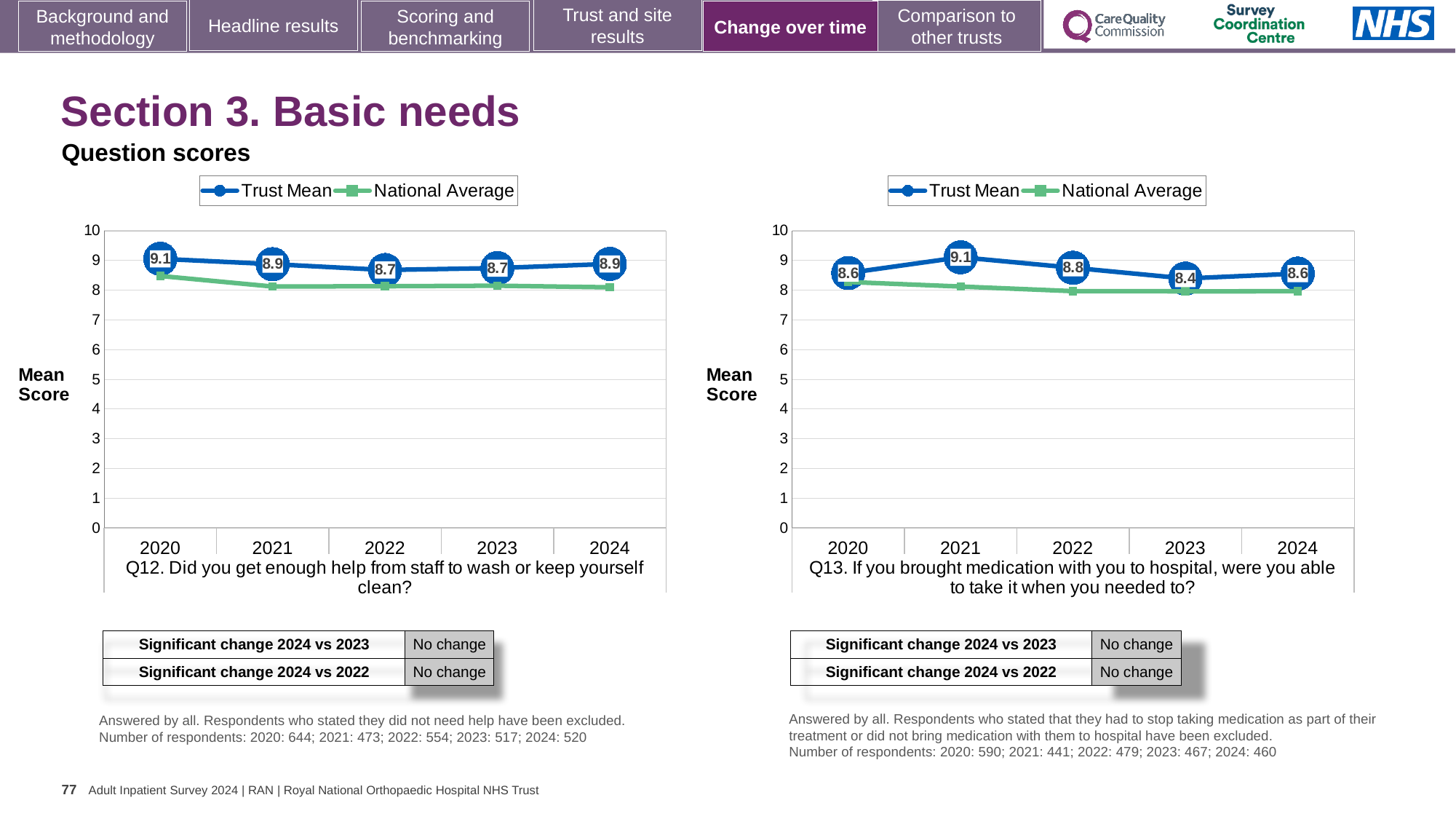
In the Q12 chart (left), what is the Trust Mean score for 2020? 9.1 In the Q13 chart (right), which year has the highest Trust Mean score? 2021 What kind of chart is the Q12 chart (left)? Line chart How many series does the legend of the Q13 chart (right) list? 2 How many years are plotted on the x axis of the Q12 chart (left)? 5 In the Q12 chart (left), is the National Average value for 2024 greater or less than 9? less In the Q12 chart (left), what is the difference between the Trust Mean scores for 2020 and 2022? 0.4 In the Q13 chart (right), what is the Trust Mean score for 2023? 8.4 In the Q12 chart (left), which is larger, the Trust Mean score for 2021 or for 2022? 2021 In the Q13 chart (right), is the National Average value for 2020 greater or less than 8? greater In the Q13 chart (right), what is the difference between the Trust Mean scores for 2021 and 2023? 0.7 In the Q13 chart (right), which year has the lowest Trust Mean score? 2023